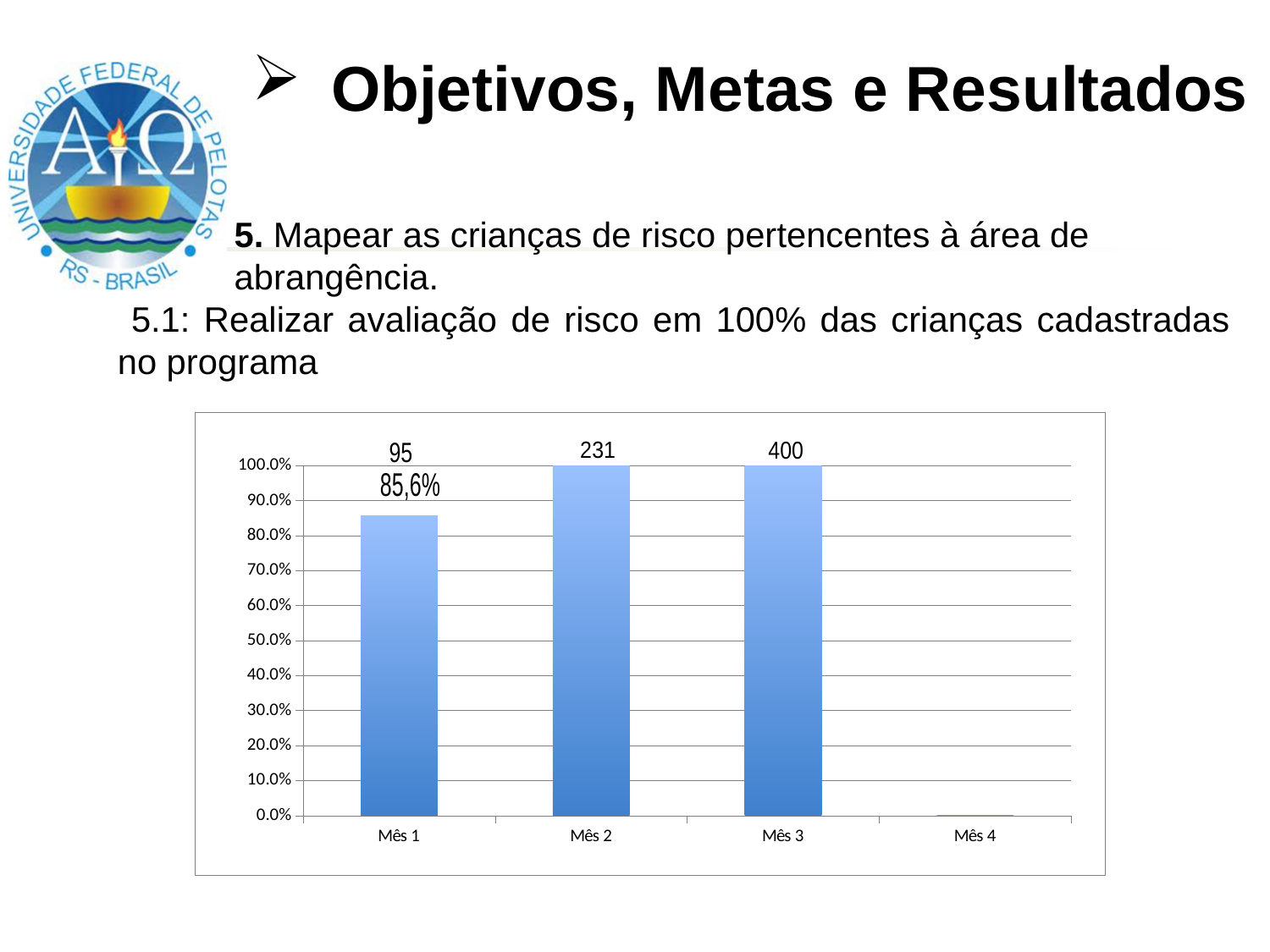
Which month has the lowest bar in the chart? Mês 4 Which is larger, the bar for Mês 1 or the bar for Mês 2? Mês 2 What kind of chart is shown on the slide? bar chart How many categories (months) are shown on the x axis of the chart? 4 What value does the bar for Mês 2 reach on the y axis? 100.0% What number is printed above the bar for Mês 3? 400 What number is printed above the bar for Mês 1? 95 What value does the bar for Mês 3 reach on the y axis? 100.0% What percentage is printed above the bar for Mês 1? 85,6% Is the value for Mês 1 greater or less than 90.0%? less What is the difference between the numbers printed above the bars for Mês 3 and Mês 2? 169 What number is printed above the bar for Mês 2? 231